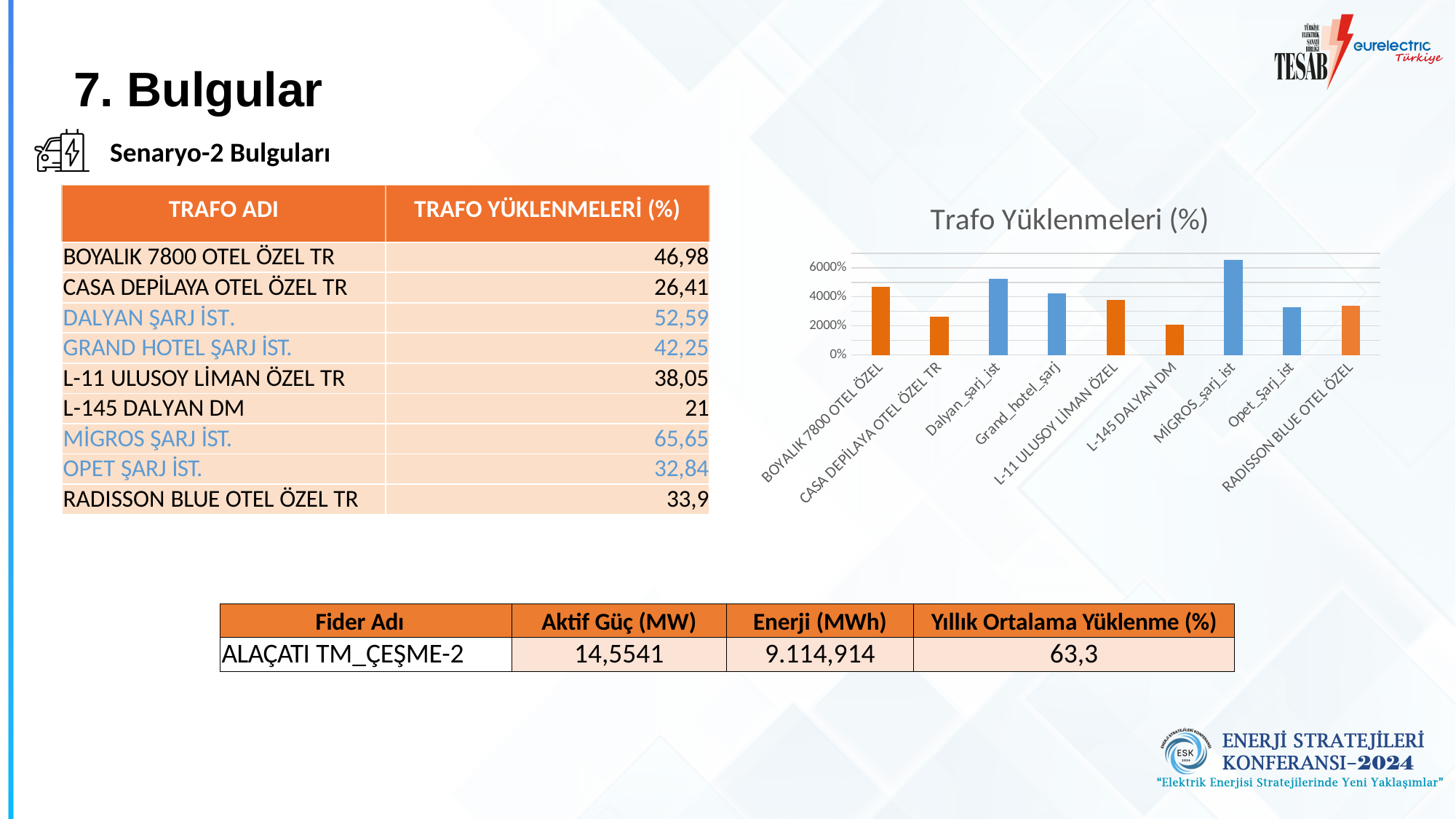
Is the value for Opet_Şarj_ist greater or less than 4000%? less What is the title of the chart? Trafo Yüklenmeleri (%) Which bar is taller, BOYALIK 7800 OTEL ÖZEL or CASA DEPİLAYA OTEL ÖZEL TR? BOYALIK 7800 OTEL ÖZEL Is the value for MİGROS_şarj_ist greater or less than 6000%? greater Which category has the tallest bar in the chart? MİGROS_şarj_ist Is the value for BOYALIK 7800 OTEL ÖZEL greater or less than 4000%? greater Which bar is taller, Dalyan_şarj_ist or Grand_hotel_şarj? Dalyan_şarj_ist What kind of chart is shown on the slide? bar chart Which category has the shortest bar in the chart? L-145 DALYAN DM How many categories are plotted in the chart? 9